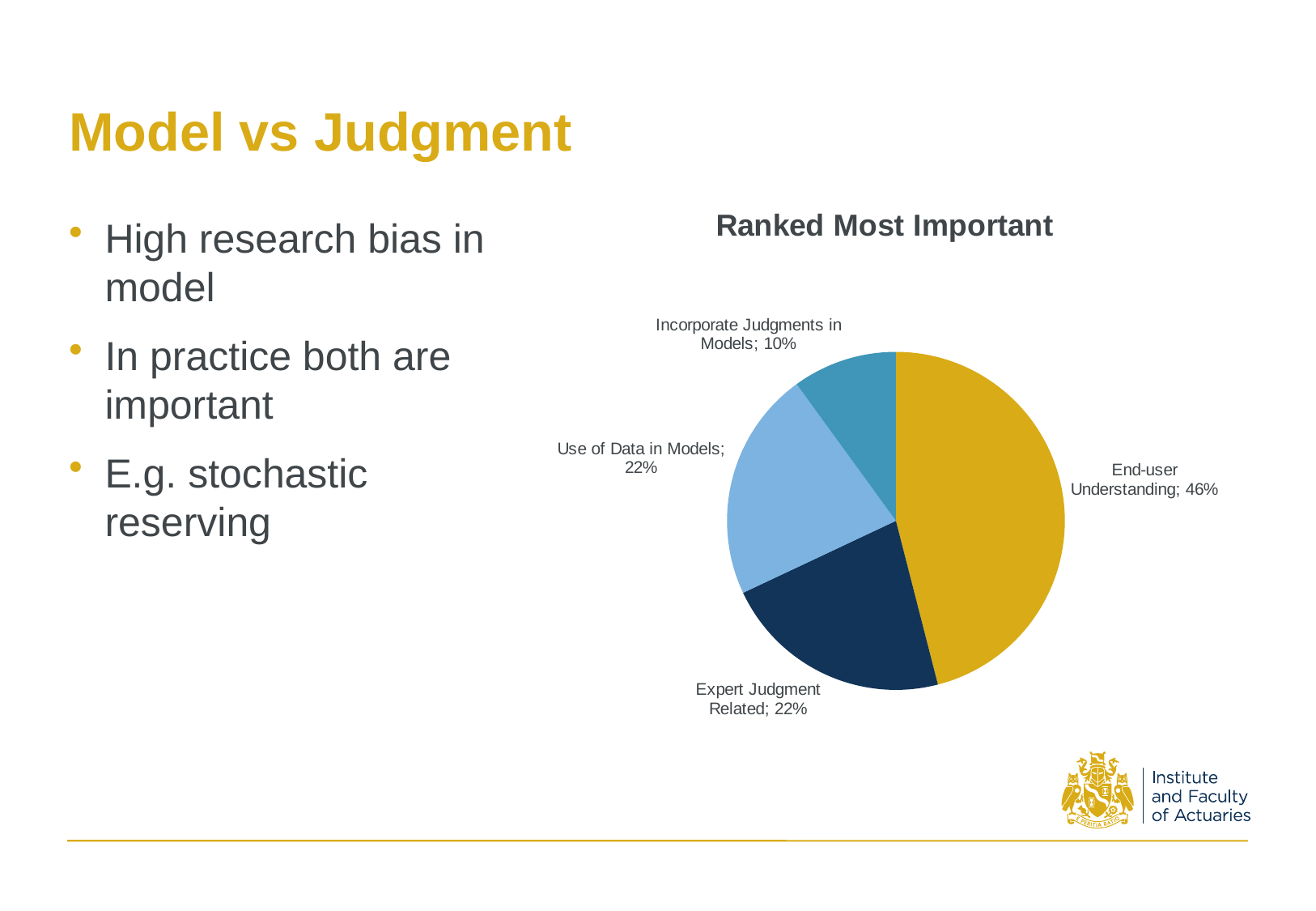
What is the value for Use of Data in Models? 22% What share of the pie is End-user Understanding? 46% How many categories are shown in the pie chart? 4 What is the value for Expert Judgment Related? 22% What colour is the End-user Understanding slice? Gold/yellow What is the difference between the End-user Understanding share and the Use of Data in Models share? 24% Which is larger, the share for Expert Judgment Related or the share for Incorporate Judgments in Models? Expert Judgment Related Which category has the smallest slice of the pie? Incorporate Judgments in Models What share of the pie is Incorporate Judgments in Models? 10% Which category has the largest slice of the pie? End-user Understanding What kind of chart is shown on the slide? Pie chart What is the title of the chart? Ranked Most Important